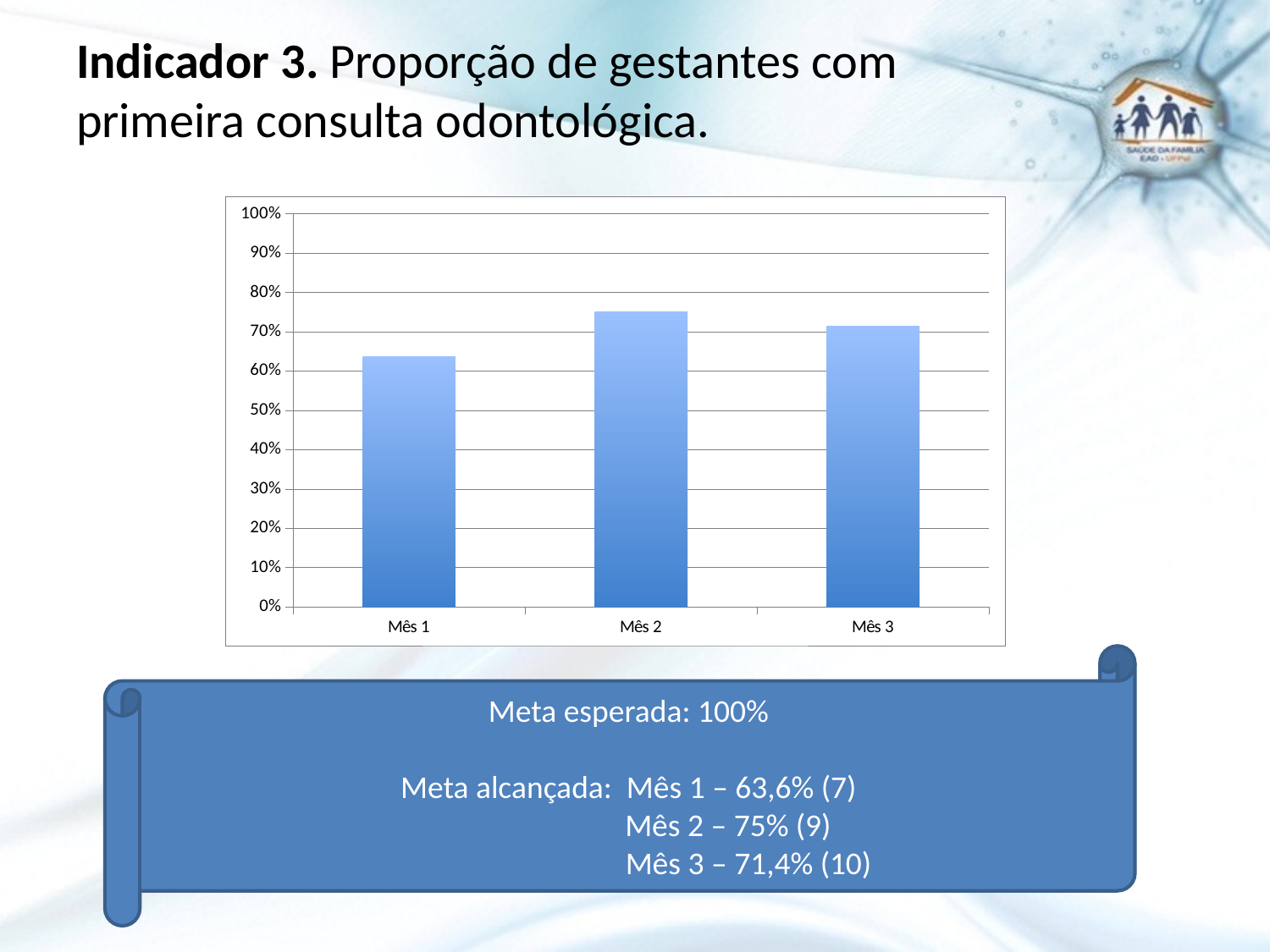
Which month has the highest bar on the chart? Mês 2 Which month has the lowest bar on the chart? Mês 1 According to the slide, what proportion was reached in Mês 3? 71,4% What is the maximum value shown on the vertical axis of the chart? 100% What is the expected target (meta esperada) stated on the slide? 100% Is the value for Mês 3 greater or less than 80%? less Which is larger, the value for Mês 2 or the value for Mês 3? Mês 2 Is the value for Mês 2 greater or less than 70%? greater According to the slide, what proportion was reached in Mês 1? 63,6% Is the value for Mês 1 greater or less than 70%? less How many categories (months) are plotted on the chart? 3 What kind of chart is shown on the slide? bar chart